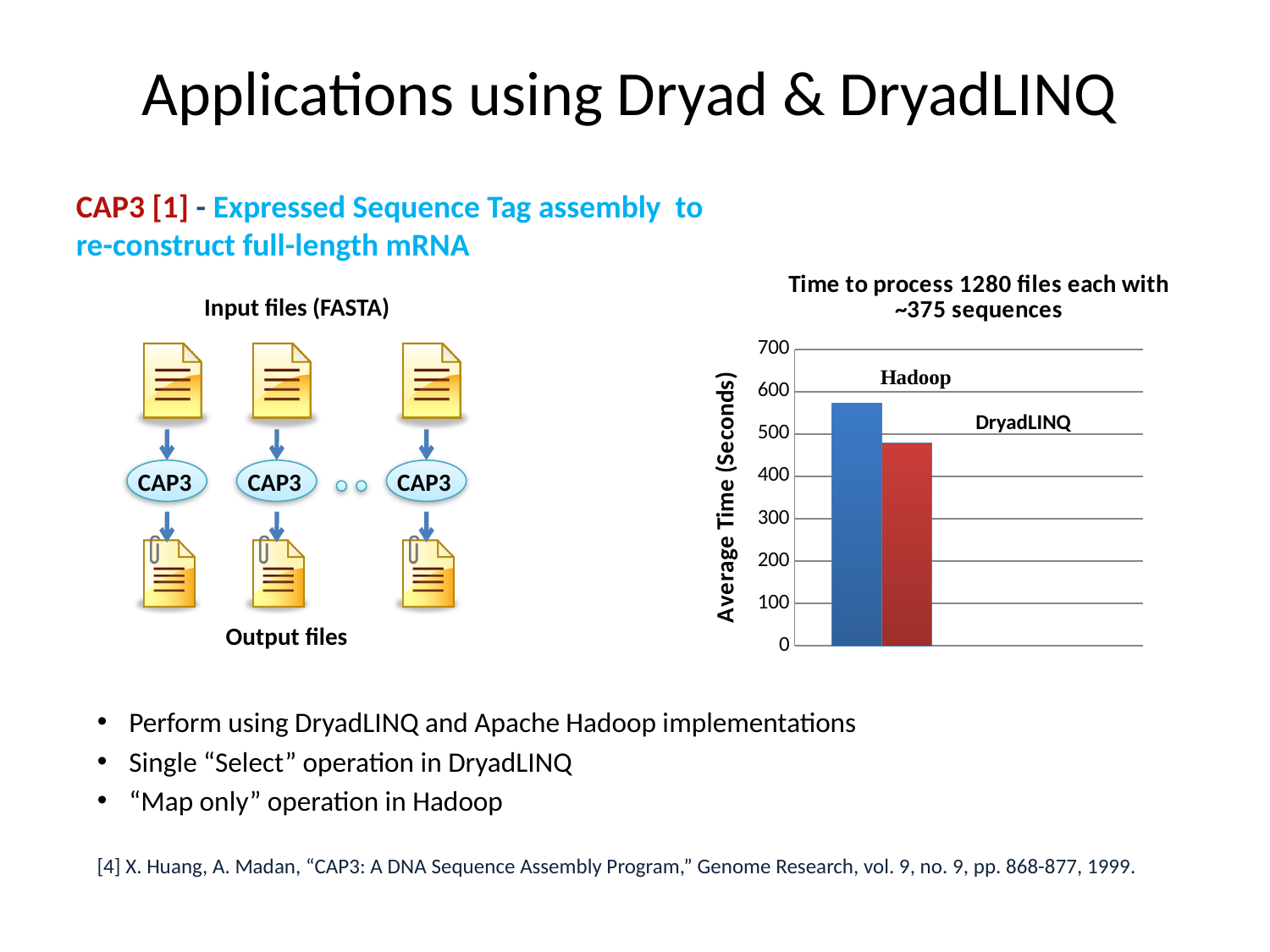
Which has a larger average time, Hadoop or DryadLINQ? Hadoop Is the average time for DryadLINQ greater or less than 500 seconds? less Is the average time for Hadoop greater or less than 500 seconds? greater What is the label on the vertical axis of the chart? Average Time (Seconds) What kind of chart is shown on the slide? bar chart Which implementation has the highest average time in the chart? Hadoop Is the average time for DryadLINQ greater or less than 400 seconds? greater How many bars are plotted in the chart? 2 What is the title of the chart? Time to process 1280 files each with ~375 sequences Which implementation has the lowest average time in the chart? DryadLINQ